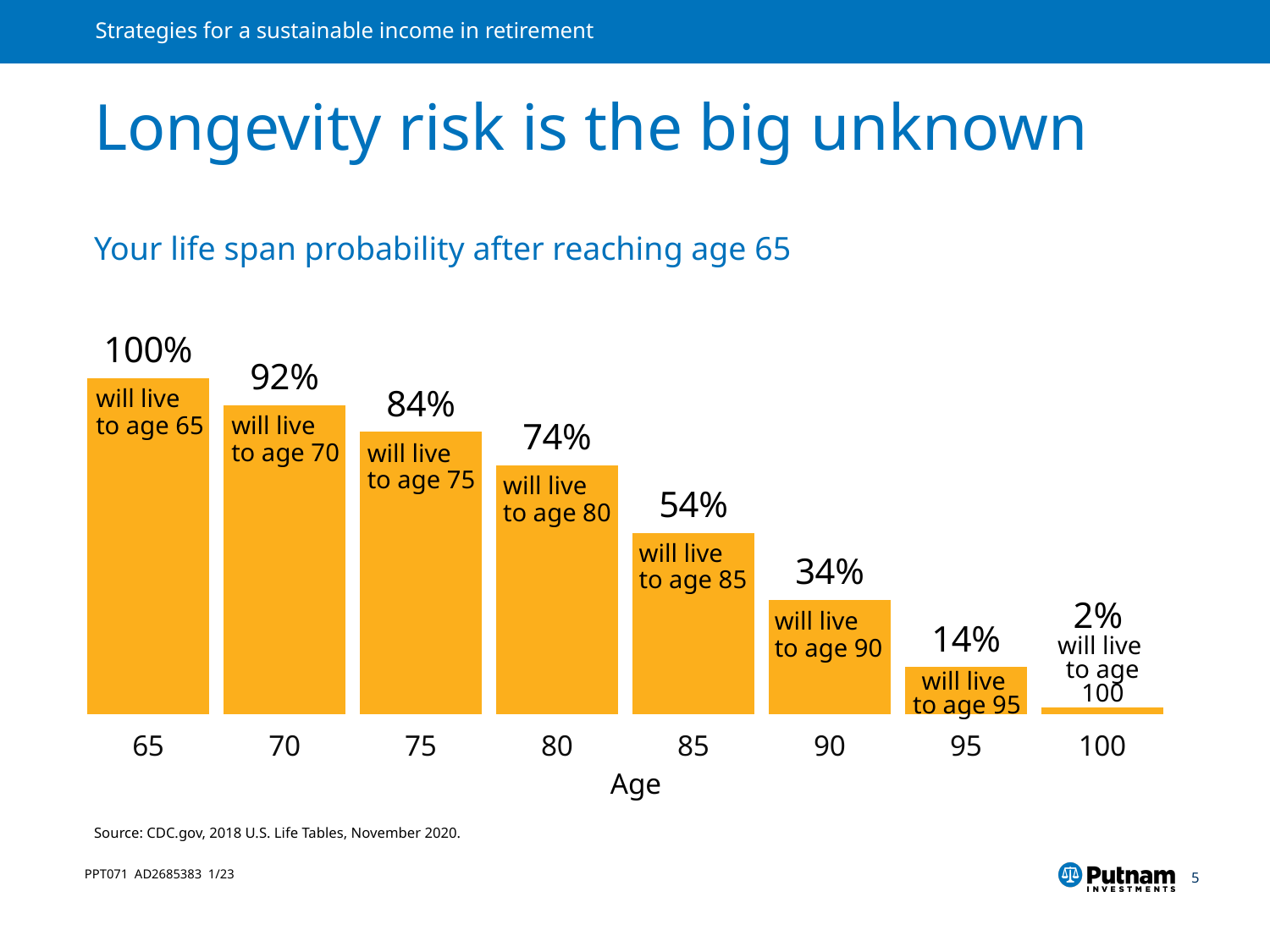
What is the difference between the probability of living to age 75 and living to age 95? 70% What is the probability of living to age 90? 34% What is the difference between the probability of living to age 70 and living to age 85? 38% What is the probability of living to age 95? 14% Which age has the highest probability shown? 65 How many age categories are shown on the x axis? 8 Which is larger, the probability of living to age 85 or to age 90? age 85 What kind of chart is this? bar chart Which age has the lowest probability shown? 100 Do the values rise or fall as age increases along the x axis? fall What is the x-axis title of the chart? Age What is the probability of living to age 80? 74%